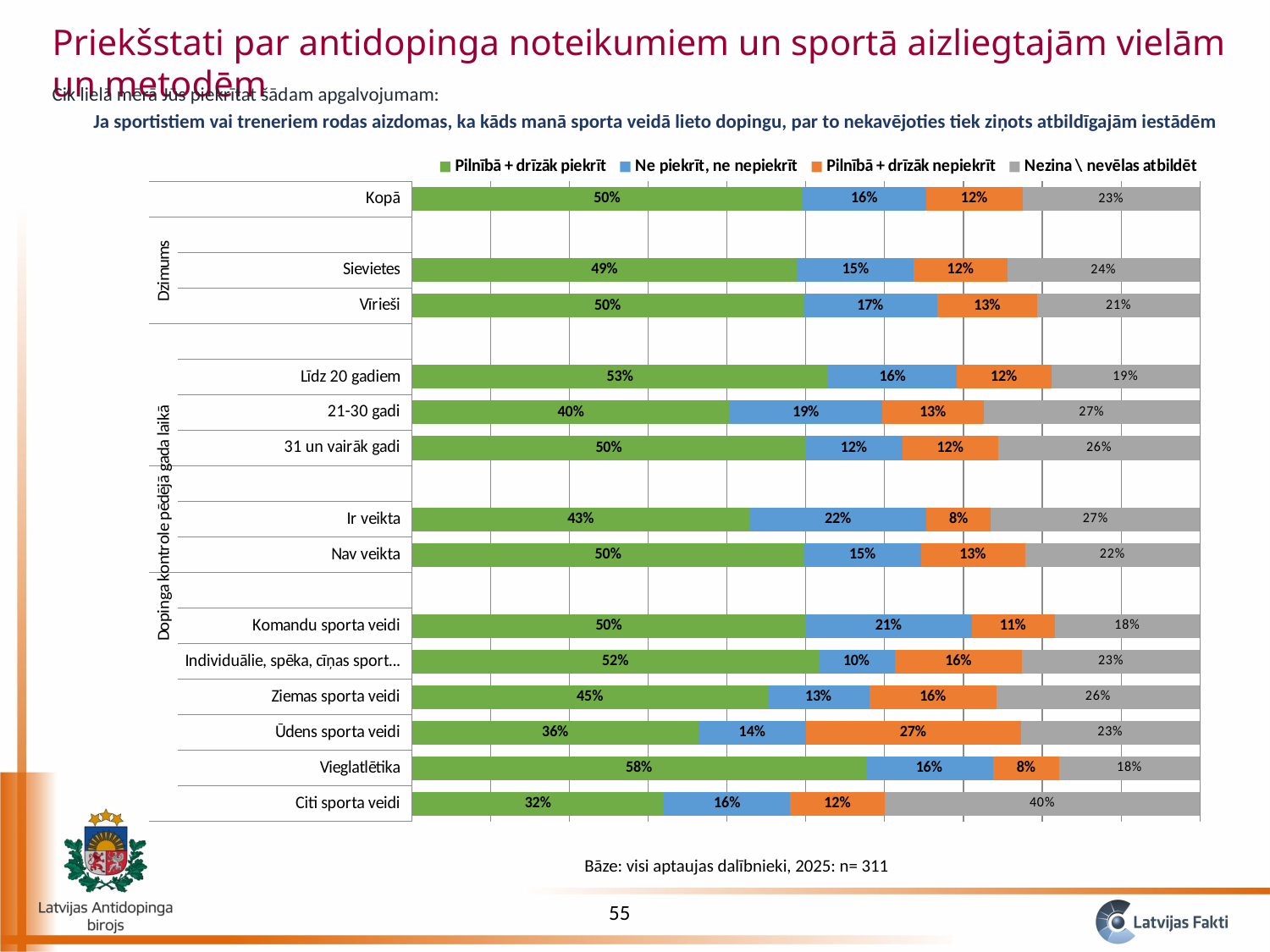
Which category has the highest value for 'Nezina \ nevēlas atbildēt'? Citi sporta veidi Which category has the lowest value for 'Pilnībā + drīzāk piekrīt'? Citi sporta veidi What is the value of 'Nezina \ nevēlas atbildēt' for Citi sporta veidi? 40% What is the difference between the 'Pilnībā + drīzāk piekrīt' values for Vieglatlētika and Ūdens sporta veidi? 22% Which is larger: the 'Ne piekrīt, ne nepiekrīt' value for Ir veikta or for Nav veikta? Ir veikta What is the value of 'Ne piekrīt, ne nepiekrīt' for 21-30 gadi? 19% Which category has the highest value for 'Pilnībā + drīzāk piekrīt'? Vieglatlētika What kind of chart is shown on the slide? stacked bar chart How many series does the legend list? 4 What is the value of 'Pilnībā + drīzāk piekrīt' for Kopā? 50% What is the value of 'Pilnībā + drīzāk nepiekrīt' for Ūdens sporta veidi? 27% What is the total of the stacked bar for Vieglatlētika? 100%